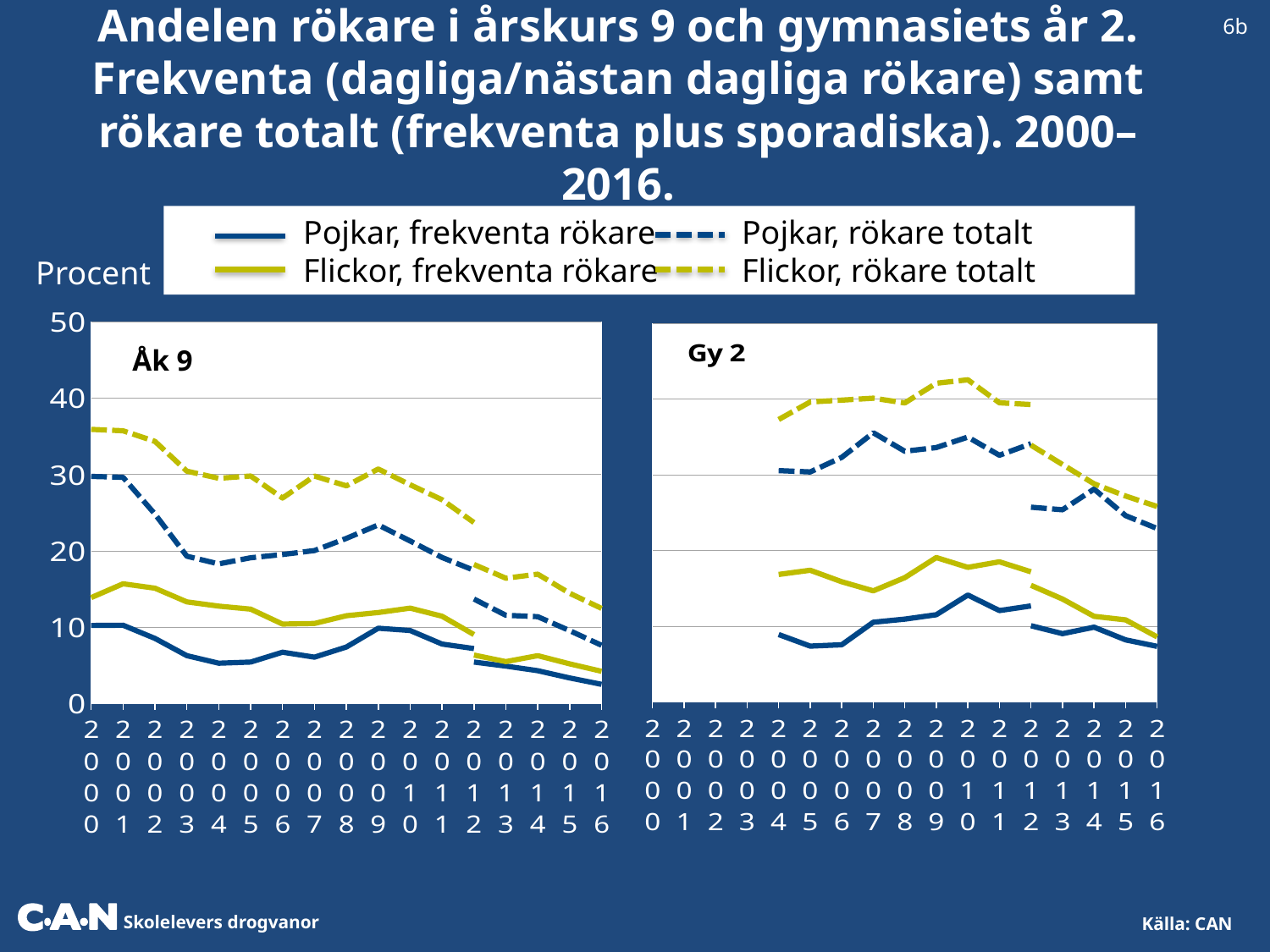
In the Gy 2 chart, is the value for Pojkar, frekventa rökare in 2004 greater or less than 10? less In the Åk 9 chart, which series has the lowest value in 2016? Pojkar, frekventa rökare How many series does the legend list? 4 What kind of chart is used on this slide for the Åk 9 and Gy 2 panels? Line chart In the Åk 9 chart, is the value for Pojkar, frekventa rökare in 2016 greater or less than 10? less In the Åk 9 chart, which is larger in 2000: Flickor, rökare totalt or Pojkar, rökare totalt? Flickor, rökare totalt In the Åk 9 chart, which series has the highest value in 2000? Flickor, rökare totalt In the Åk 9 chart, does Pojkar, rökare totalt rise or fall overall from 2000 to 2016? Fall What is the label on the vertical axis of the charts? Procent In the Åk 9 chart, is the value for Flickor, rökare totalt in 2000 greater or less than 30? greater How many years are labelled on the x axis of the Åk 9 chart? 17